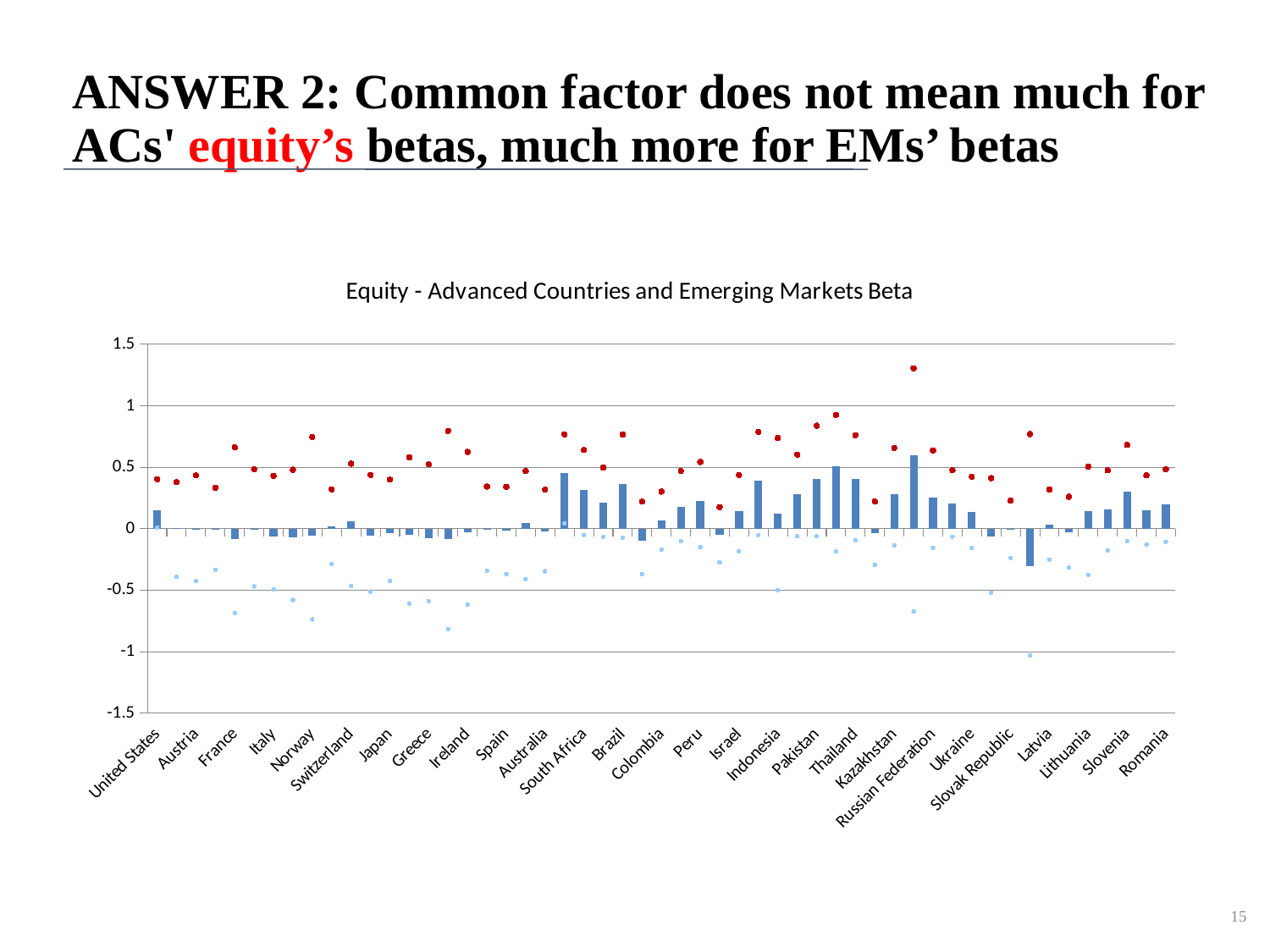
Is the light blue dot for Ireland greater or less than -0.5? less Which has the larger blue bar, Russian Federation or United States? Russian Federation What kind of chart is shown on the slide? bar chart What is the title of the chart? Equity - Advanced Countries and Emerging Markets Beta Is the blue bar for United States greater or less than 0.5? less Which has the higher red dot, Kazakhstan or United States? Kazakhstan